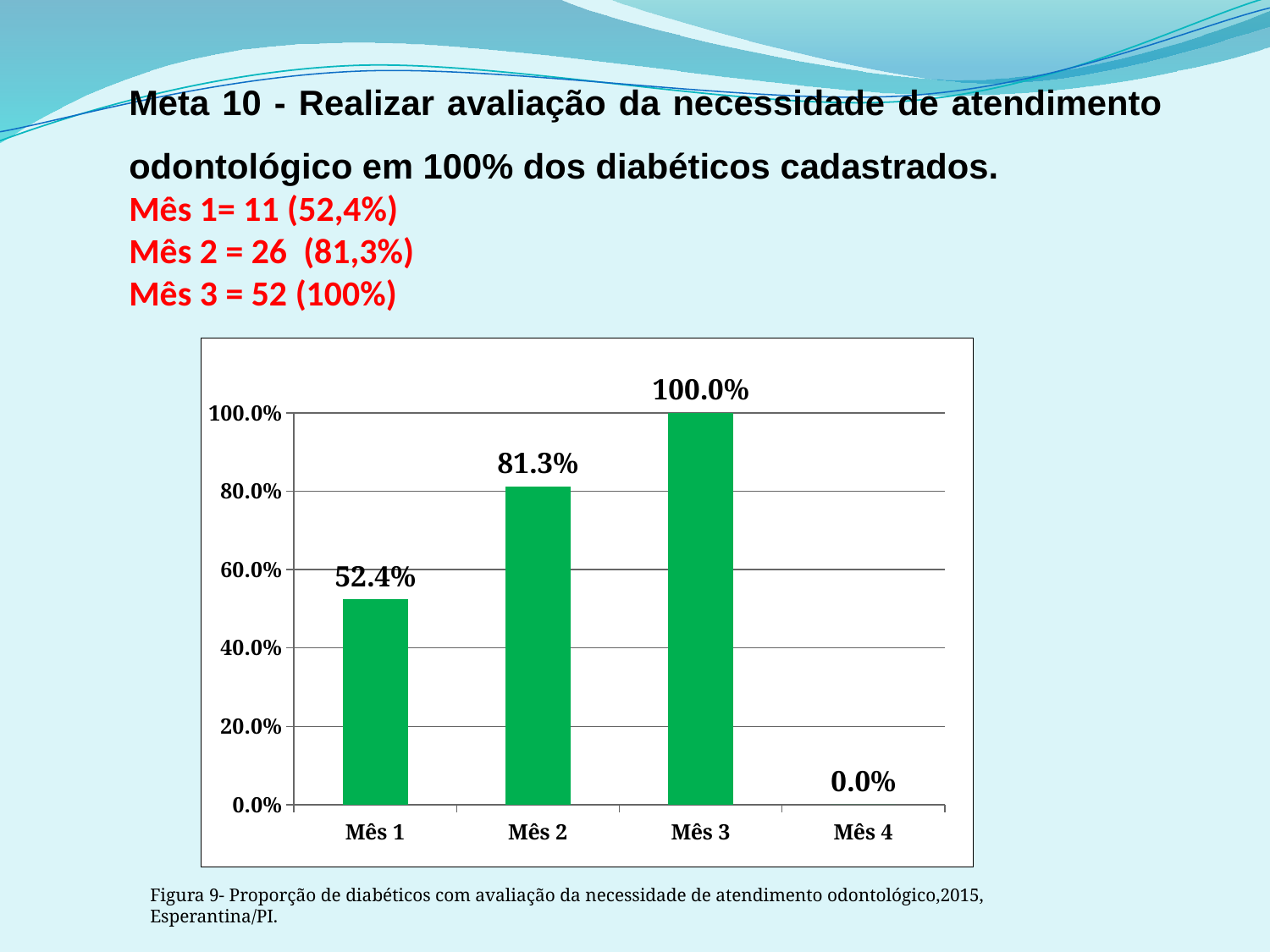
What is the value for Mês 2? 81.3% What is the value for Mês 3? 100.0% Is the value for Mês 1 greater or less than 60.0%? less How many months are shown on the x axis? 4 What is the value for Mês 4? 0.0% What kind of chart is shown? bar chart Which month has the highest value? Mês 3 What is the difference between the values for Mês 2 and Mês 1? 28.9% Which is larger, the value for Mês 2 or the value for Mês 1? Mês 2 Do the values rise or fall from Mês 1 to Mês 3? rise What is the value for Mês 1? 52.4% Which month has the lowest value? Mês 4